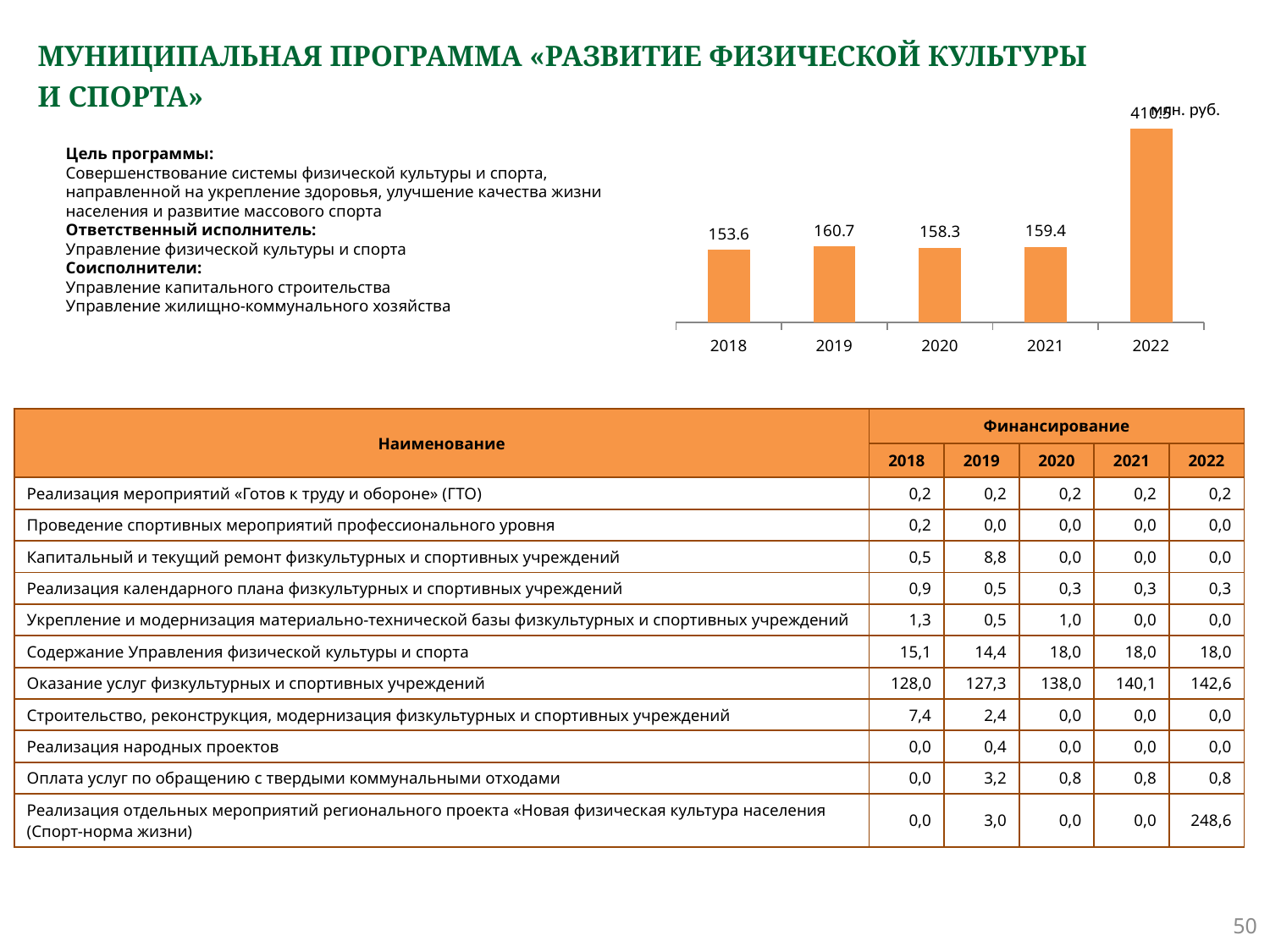
What is the value for 2018 in the chart? 153.6 Which year has the highest bar in the chart? 2022 What is the difference between the values for 2019 and 2018 in the chart? 7.1 Which is larger in the chart, the value for 2019 or the value for 2020? 2019 How many years are shown on the x axis of the chart? 5 What is the value for 2021 in the chart? 159.4 What unit is indicated in the top right corner of the chart? млн. руб. What type of chart is shown on the slide? bar chart What is the value for 2020 in the chart? 158.3 What is the value for 2019 in the chart? 160.7 Which year has the lowest value in the chart? 2018 What is the difference between the values for 2021 and 2020 in the chart? 1.1